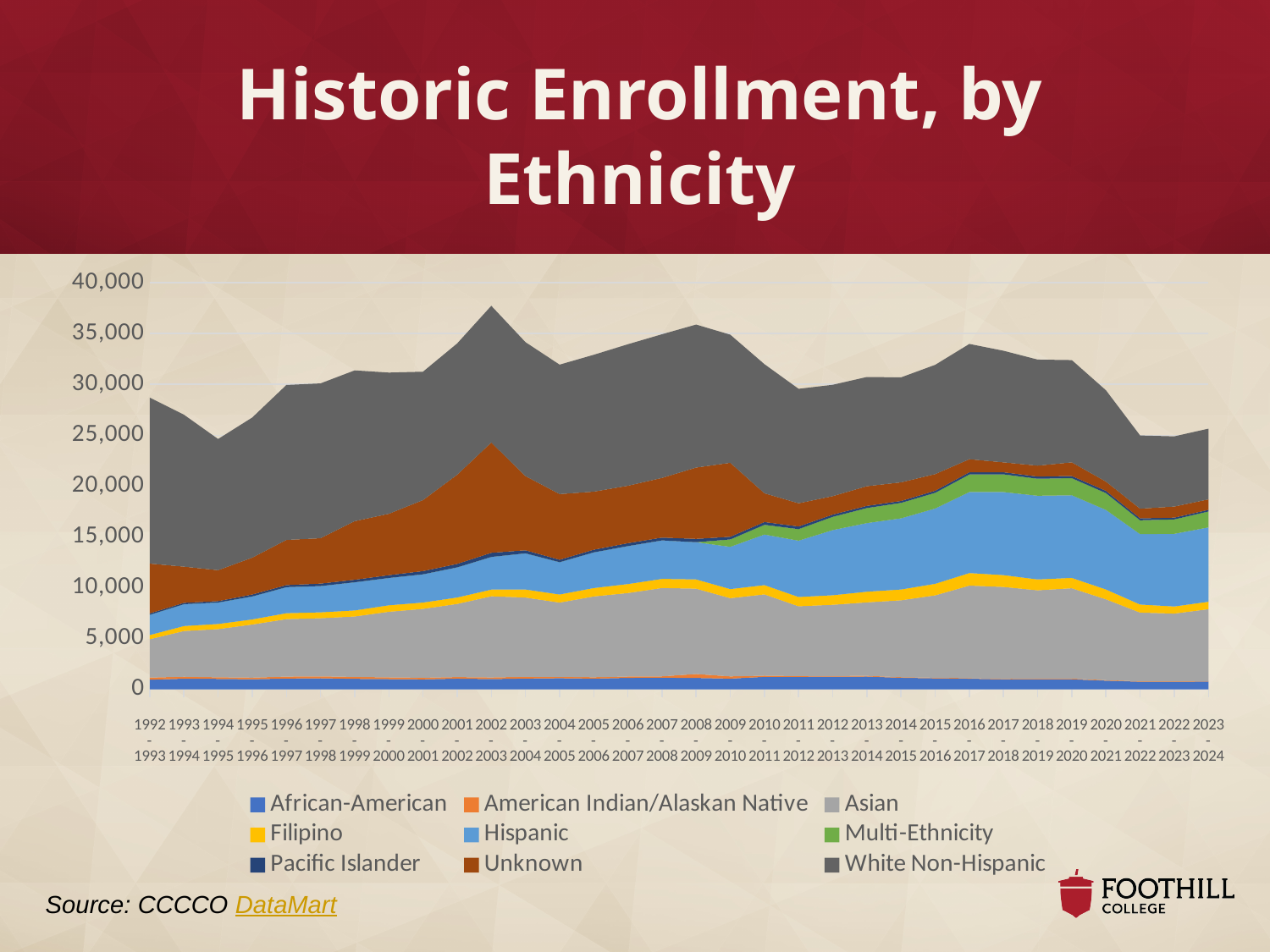
Is the total enrollment for 2002-2003 greater or less than 35,000? greater How many series does the legend list? 9 Is the total enrollment for 2023-2024 greater or less than 30,000? less Does total enrollment rise or fall from 2019-2020 to 2021-2022? fall Is the total enrollment for 2016-2017 greater or less than 30,000? greater In 2023-2024, which is larger, the Hispanic enrollment or the Unknown enrollment? Hispanic In which academic year is the total enrollment highest? 2002-2003 Which series is plotted at the top of the stack? White Non-Hispanic What is the title of the chart? Historic Enrollment, by Ethnicity What kind of chart is shown on the slide? stacked area chart How many academic years are shown along the x axis? 32